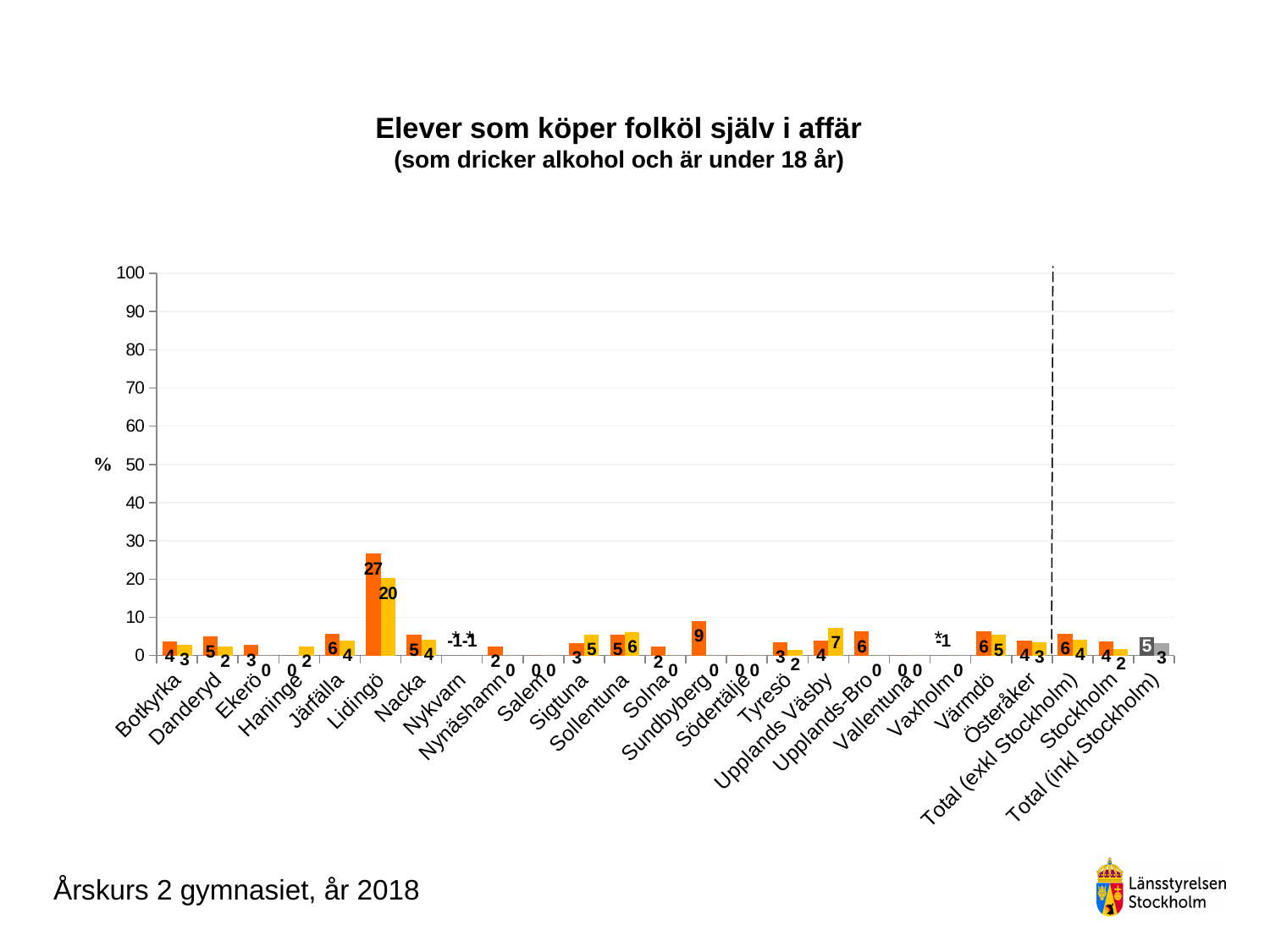
What is the value of the orange bar for Sundbyberg? 9 What is the difference between the orange and yellow bars for Lidingö? 7 Is the value of the orange bar for Lidingö greater or less than 20? greater What type of chart is shown on the slide? bar chart What is the title of the chart? Elever som köper folköl själv i affär What is the value of the yellow bar for Lidingö? 20 What is the value of the yellow bar for Upplands Väsby? 7 Which is larger for Sollentuna, the orange bar or the yellow bar? the yellow bar What is the value of the orange bar for Lidingö? 27 Which category has the highest orange bar? Lidingö How many categories are shown on the x axis? 25